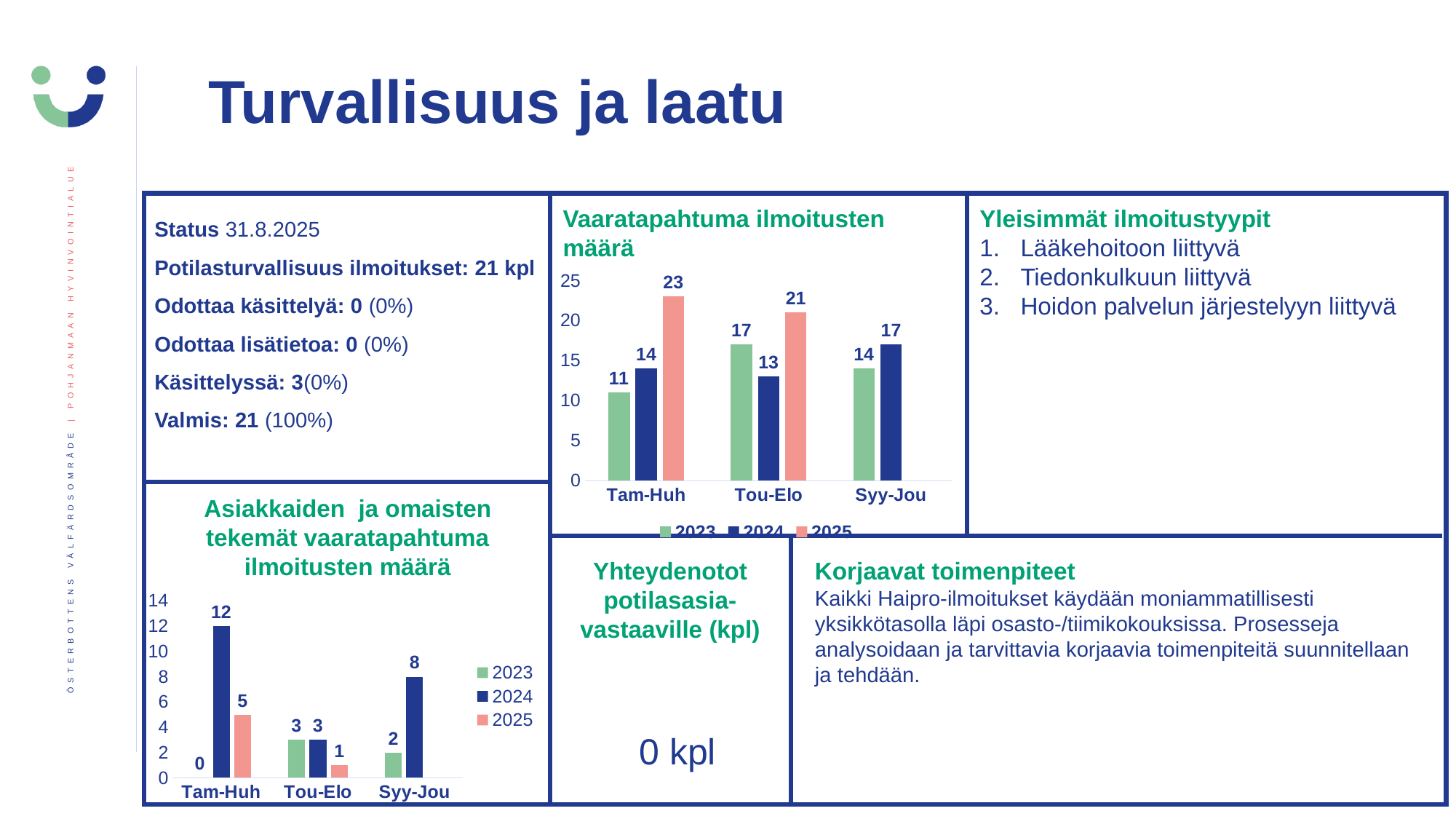
In the 'Vaaratapahtuma ilmoitusten määrä' chart, which period has the highest 2023 value? Tou-Elo In the 'Asiakkaiden ja omaisten tekemät vaaratapahtuma ilmoitusten määrä' chart, what is the value for 2025 in Tou-Elo? 1 What kind of chart is 'Vaaratapahtuma ilmoitusten määrä'? Bar chart In the 'Vaaratapahtuma ilmoitusten määrä' chart, what is the value for 2024 in Tou-Elo? 13 How many series does the legend of the 'Vaaratapahtuma ilmoitusten määrä' chart list? 3 In the 'Asiakkaiden ja omaisten tekemät vaaratapahtuma ilmoitusten määrä' chart, what is the difference between the 2024 values in Tam-Huh and Syy-Jou? 4 In the 'Vaaratapahtuma ilmoitusten määrä' chart, which is larger in Syy-Jou: 2023 or 2024? 2024 In the 'Asiakkaiden ja omaisten tekemät vaaratapahtuma ilmoitusten määrä' chart, which period has the lowest 2023 value? Tam-Huh How many periods are shown on the x axis of the 'Asiakkaiden ja omaisten tekemät vaaratapahtuma ilmoitusten määrä' chart? 3 In the 'Asiakkaiden ja omaisten tekemät vaaratapahtuma ilmoitusten määrä' chart, what is the value for 2024 in Tam-Huh? 12 In the 'Vaaratapahtuma ilmoitusten määrä' chart, what is the value for 2025 in Tam-Huh? 23 In the 'Vaaratapahtuma ilmoitusten määrä' chart, what is the difference between the 2025 and 2023 values in Tam-Huh? 12